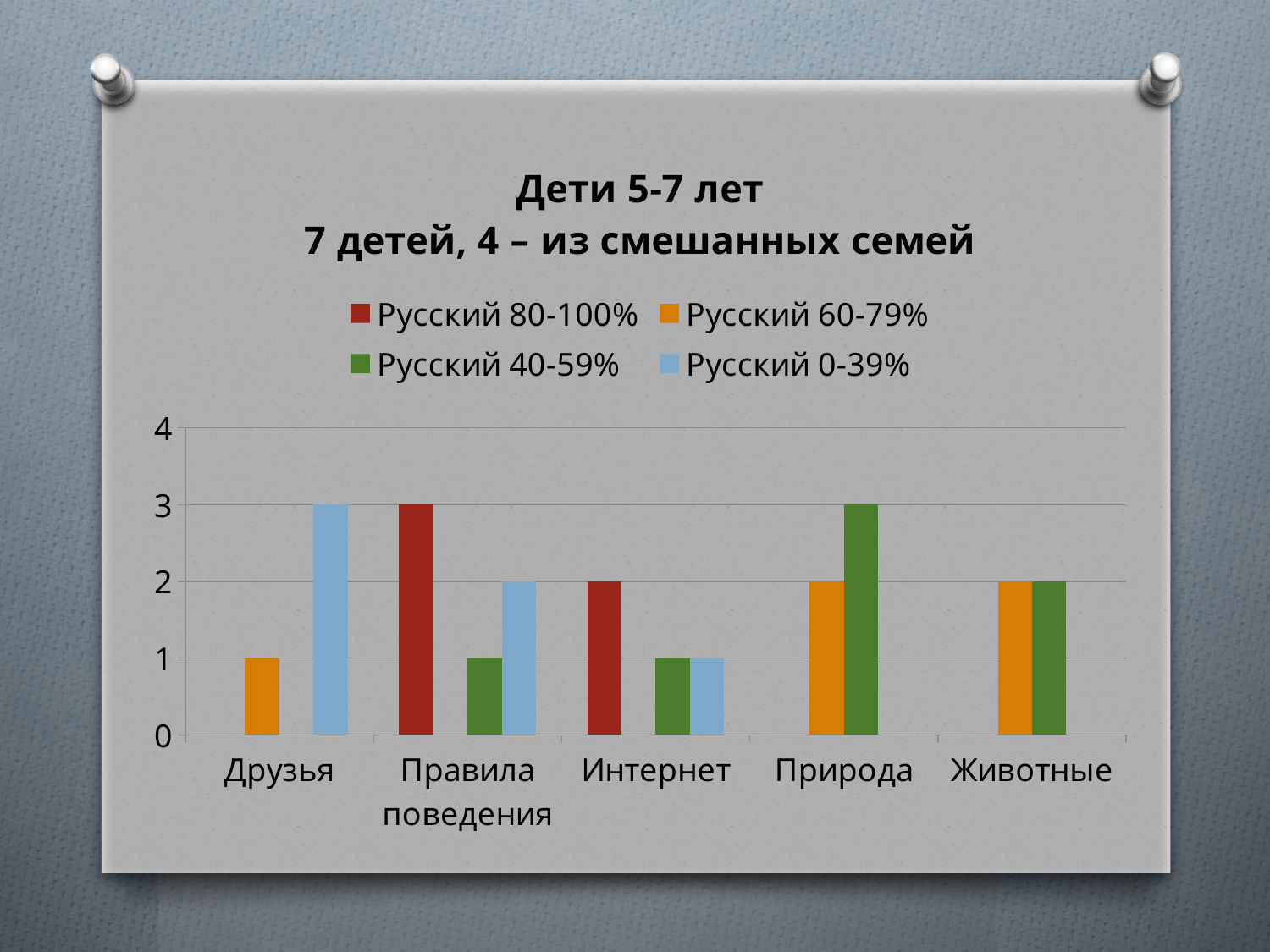
What colour represents the Русский 80-100% series? red What is the value for Русский 40-59% in the Природа category? 3 How many categories are shown on the x axis? 5 What is the value for Русский 80-100% in the Правила поведения category? 3 Which is larger in the Правила поведения category: Русский 0-39% or Русский 40-59%? Русский 0-39% What is the value for Русский 0-39% in the Друзья category? 3 Which series has the highest value in the Интернет category? Русский 80-100% What type of chart is shown on the slide? bar chart What is the title of the chart? Дети 5-7 лет 7 детей, 4 – из смешанных семей What is the difference between Русский 0-39% and Русский 60-79% in the Друзья category? 2 How many series does the legend list? 4 What is the value for Русский 60-79% in the Животные category? 2